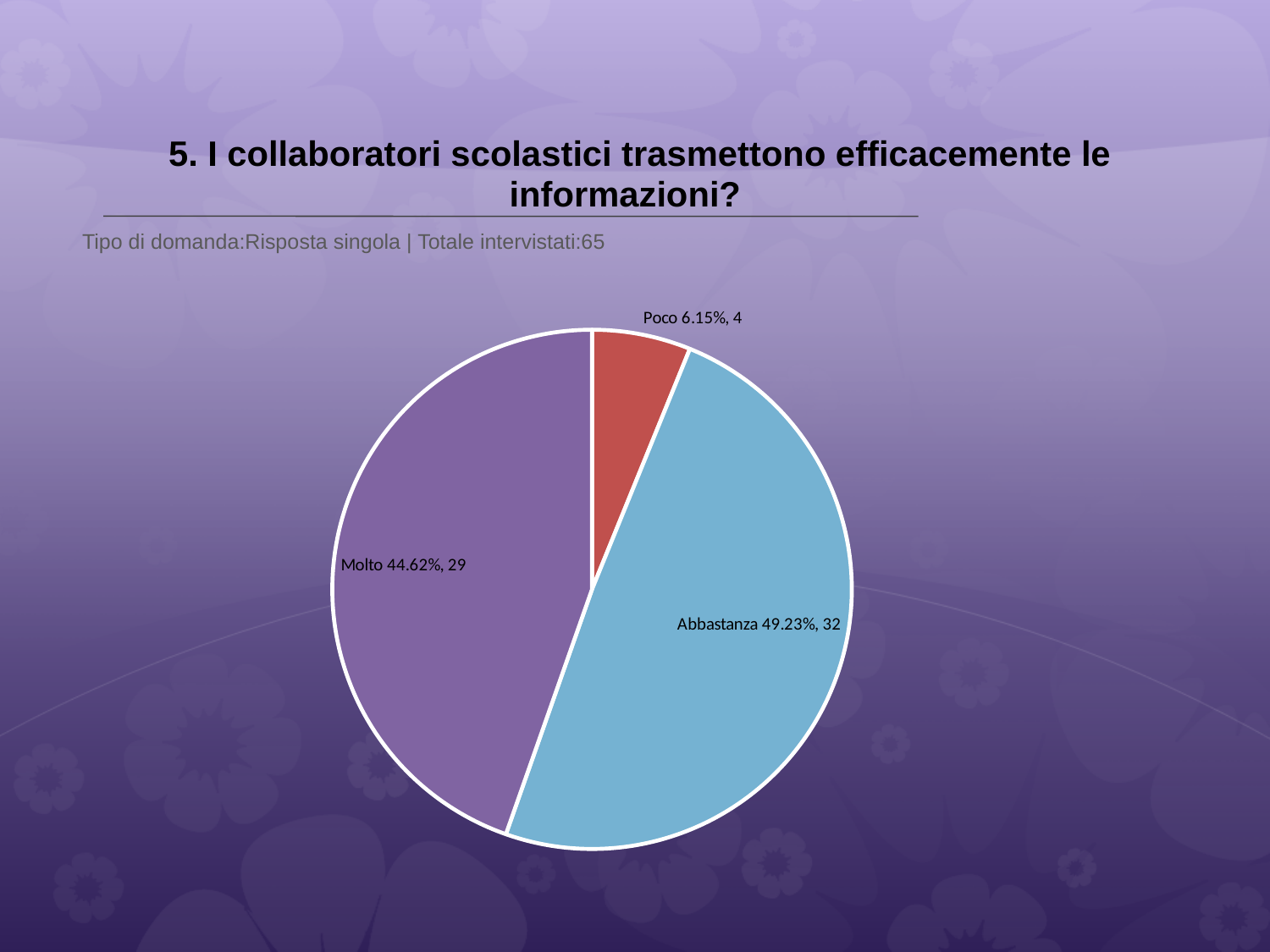
What is the difference in respondent count between Abbastanza and Molto? 3 How many respondents answered Molto? 29 What kind of chart is shown on the slide? pie chart How many respondents answered Poco? 4 What percentage share does the Poco slice have? 6.15% What is the total number of respondents (Totale intervistati) stated on the slide? 65 Which response category has the largest slice? Abbastanza How many slices does the pie chart have? 3 What percentage share does the Molto slice have? 44.62% Which response category has the smallest slice? Poco What percentage share does the Abbastanza slice have? 49.23% How many respondents answered Abbastanza? 32